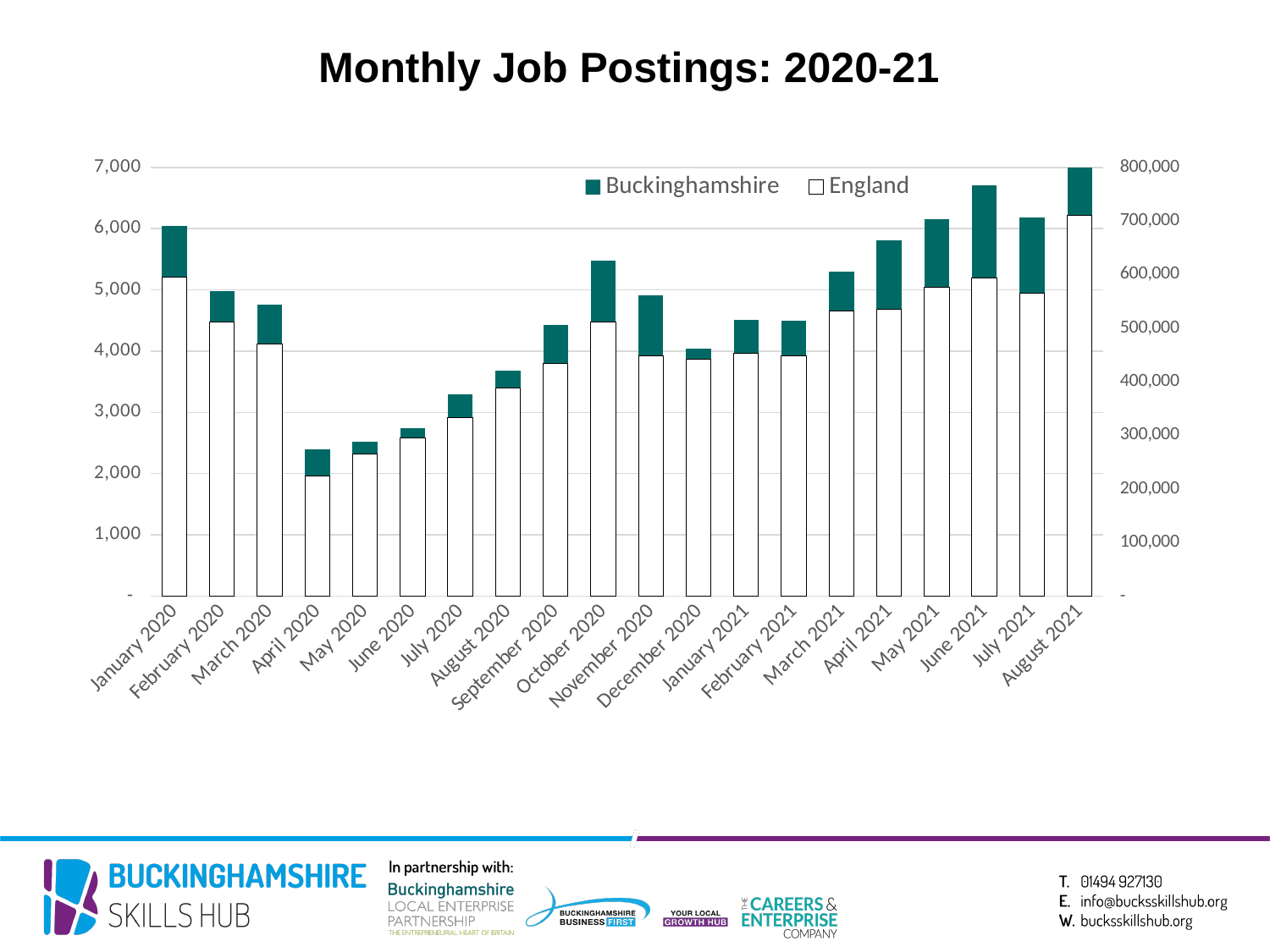
From April 2020 to August 2021, do the bars generally rise or fall? Rise How many series does the legend list? 2 Which month has the tallest bar overall? August 2021 How many months are plotted along the x axis? 20 Which bar is taller, June 2021 or August 2021? August 2021 What is the title of the chart? Monthly Job Postings: 2020-21 What kind of chart is shown on the slide? Bar chart Which bar is taller, October 2020 or November 2020? October 2020 Which two series are shown in the legend? Buckinghamshire and England Which bar is taller, January 2020 or February 2020? January 2020 Which month has the shortest bar overall? April 2020